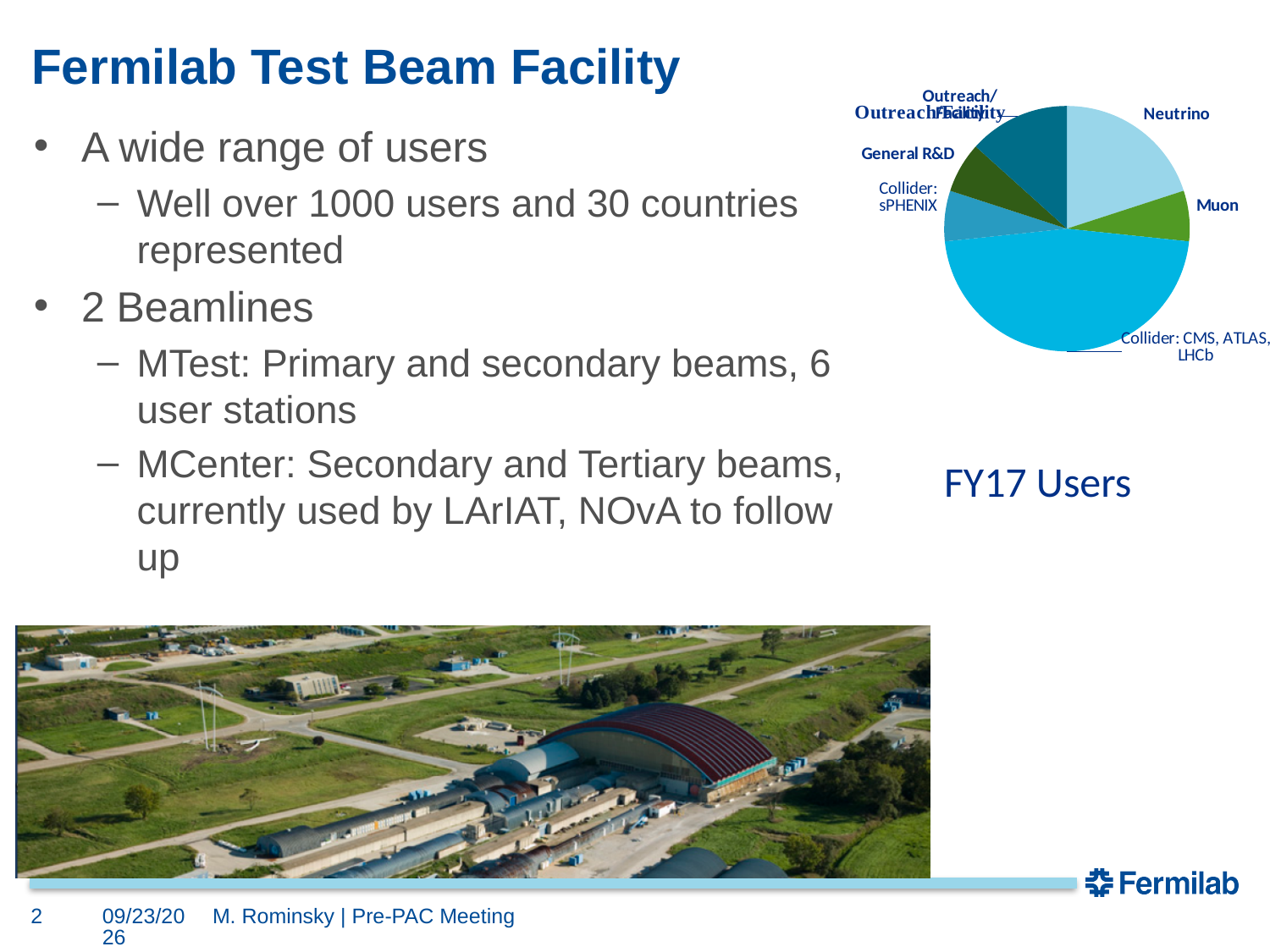
In the FY17 Users pie chart, which slice is larger: Collider: CMS, ATLAS, LHCb or Neutrino? Collider: CMS, ATLAS, LHCb Which category in the FY17 Users pie chart is labelled with the light blue slice at the top right? Neutrino In the FY17 Users pie chart, which slice is larger: Neutrino or Collider: sPHENIX? Neutrino Which category has the largest slice in the FY17 Users pie chart? Collider: CMS, ATLAS, LHCb What kind of chart is shown on the slide? pie chart How many slices does the FY17 Users pie chart have? 6 What is the title of the pie chart? FY17 Users In the FY17 Users pie chart, which slice is larger: Neutrino or Muon? Neutrino